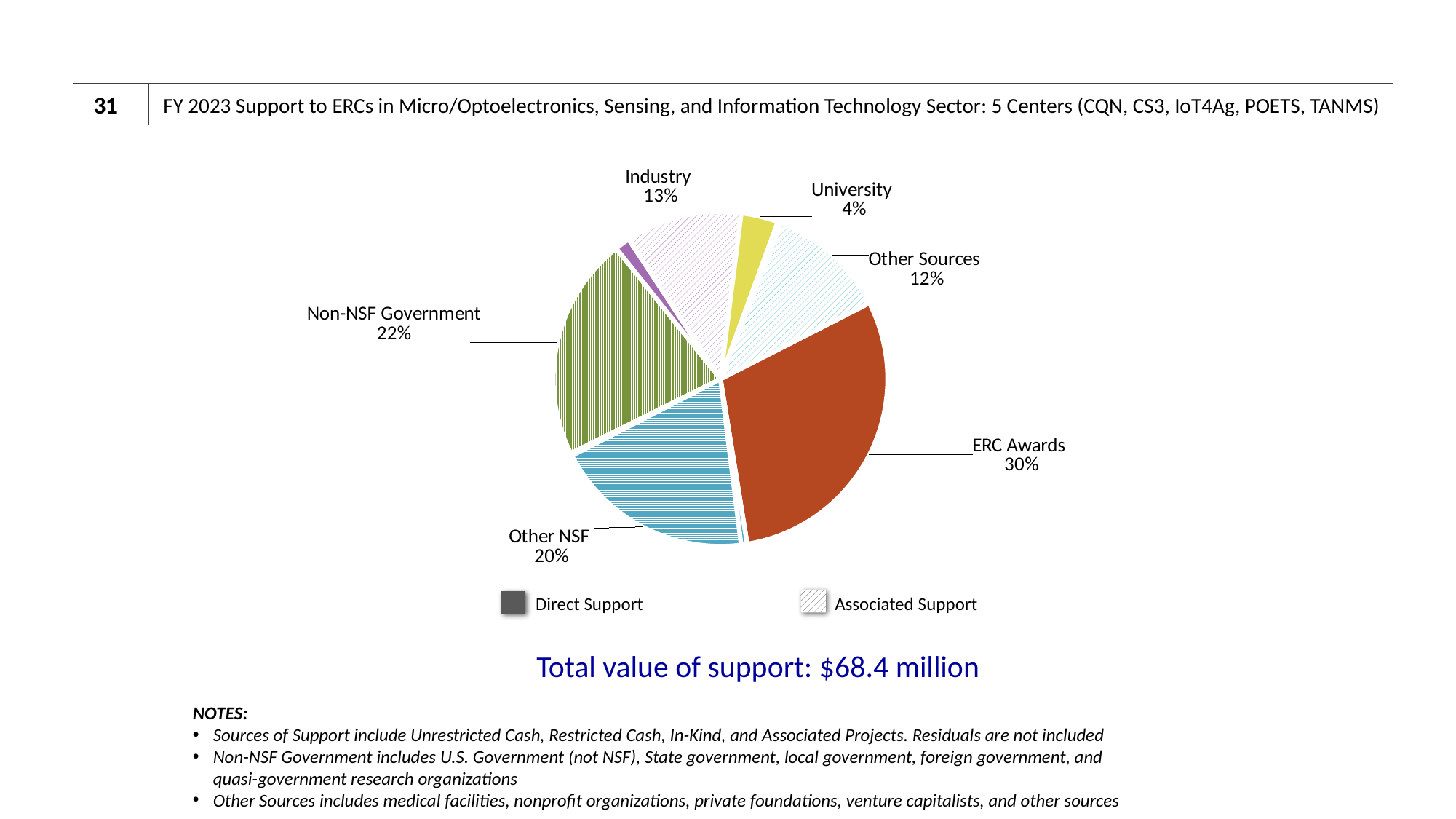
What percentage of support comes from ERC Awards? 30% What is the total value of support stated on the slide? $68.4 million What percentage is shown for Other NSF? 20% What share of the pie is Non-NSF Government? 22% Which labeled source has the smallest share of support? University What percentage is shown for University? 4% Which is larger, the share for Industry or the share for Other Sources? Industry What kind of chart is shown on the slide? Pie chart What is the difference in percentage points between ERC Awards and Other NSF? 10 How many entries does the legend list? 2 What percentage is shown for Industry? 13% Which labeled source has the largest share of support? ERC Awards